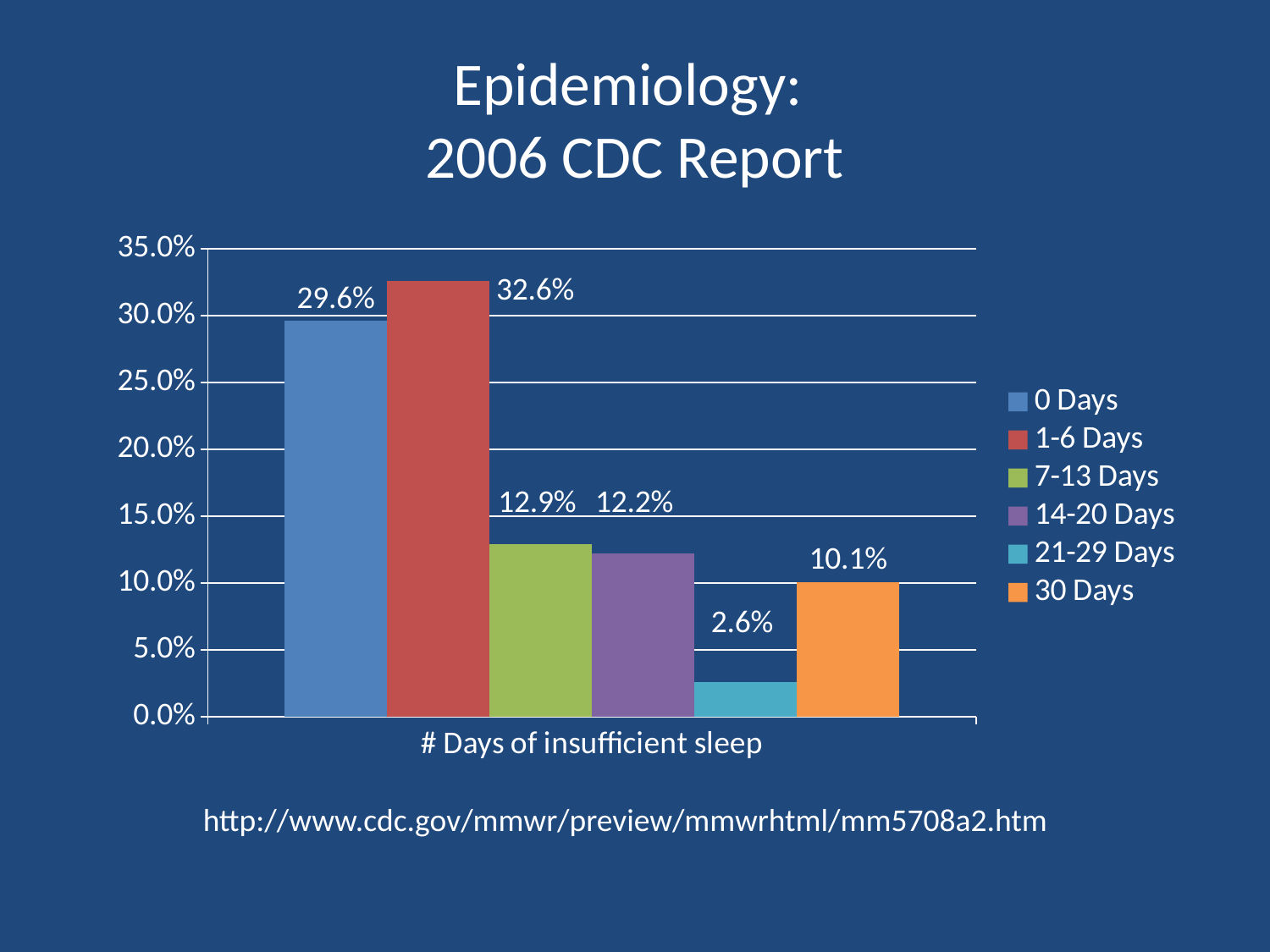
Which category has the highest value? 1-6 Days What kind of chart is shown on the slide? bar chart What is the difference between the values for 7-13 Days and 14-20 Days? 0.7% What is the x-axis label of the chart? # Days of insufficient sleep Which category has the lowest value? 21-29 Days What is the value for 1-6 Days? 32.6% What is the value for 21-29 Days? 2.6% What is the difference between the values for 1-6 Days and 0 Days? 3.0% What is the value for 30 Days? 10.1% Is the value for 0 Days greater or less than 25.0%? greater How many series does the legend list? 6 Which is larger, the value for 30 Days or the value for 21-29 Days? 30 Days